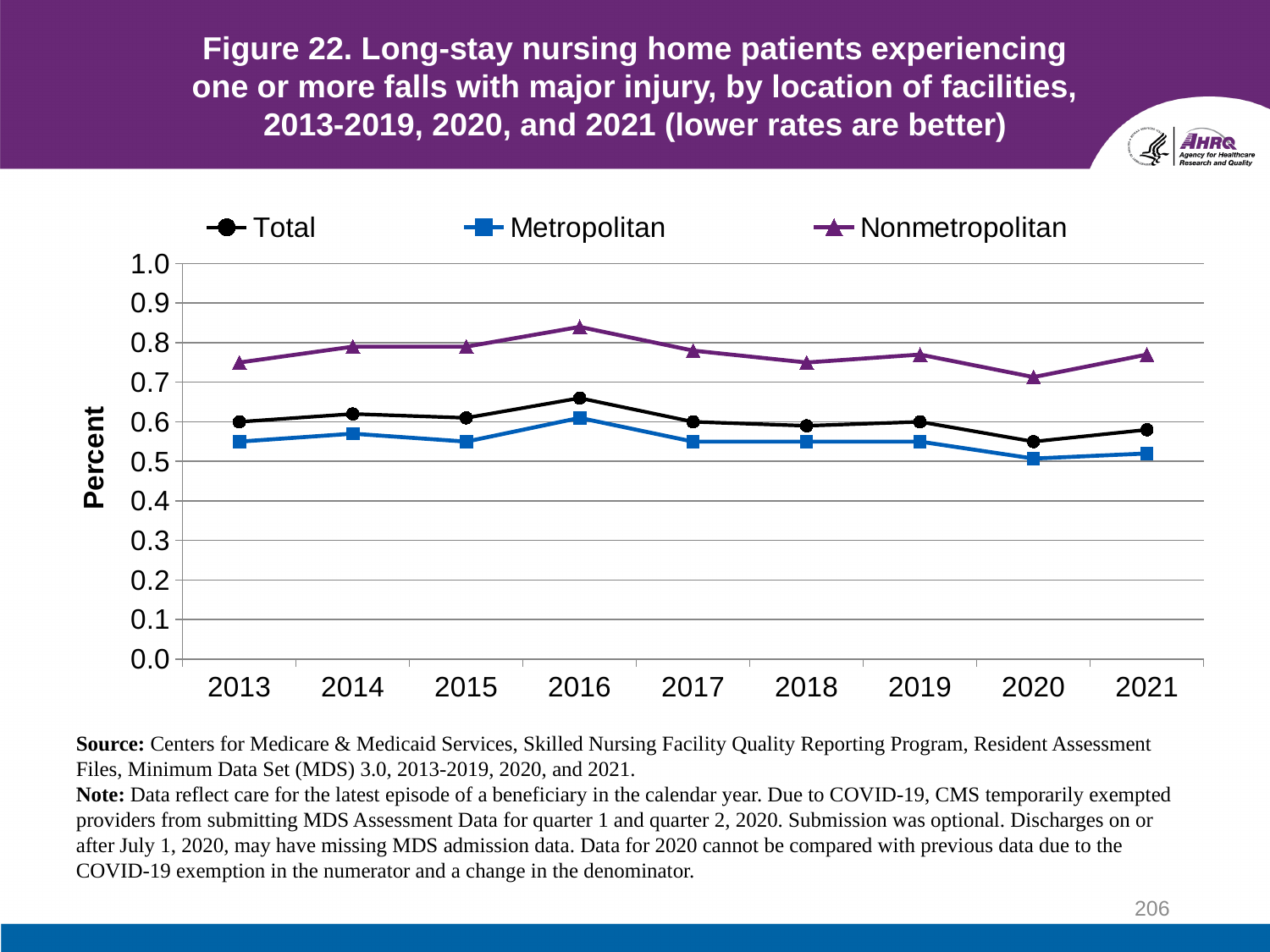
What is the label on the y axis? Percent In which year is the Total value highest? 2016 Is the Nonmetropolitan value for 2020 greater or less than 0.8? less Which series has the larger value in 2018, Metropolitan or Nonmetropolitan? Nonmetropolitan How many series does the legend list? 3 Is the Total value for 2016 greater or less than 0.6? greater What kind of chart is shown on the slide? line chart Does the Nonmetropolitan line rise or fall from 2016 to 2020? fall Is the Nonmetropolitan value for 2016 greater or less than 0.8? greater In which year is the Nonmetropolitan value lowest? 2020 In which year is the Nonmetropolitan value highest? 2016 How many years are plotted along the x axis? 9